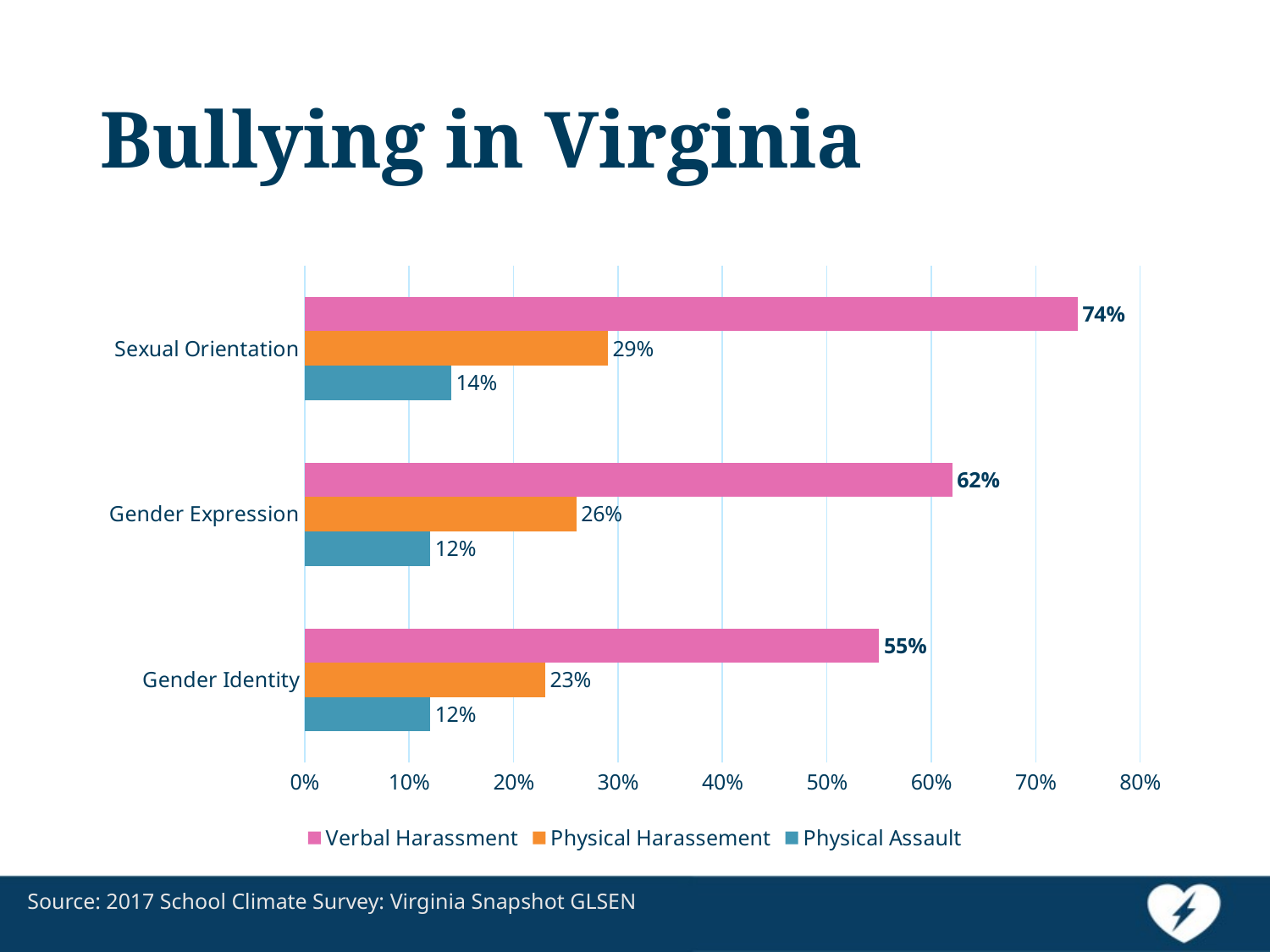
Is the Verbal Harassment value for Gender Expression greater or less than 60%? greater Which category has the highest Verbal Harassment value? Sexual Orientation What is the Physical Assault value for Gender Expression? 12% What kind of chart is shown on the slide? bar chart How many categories are shown on the chart? 3 Which category has the lowest Physical Harassement value? Gender Identity How many series does the legend list? 3 What is the title of the slide containing the chart? Bullying in Virginia What is the difference between the Verbal Harassment values for Sexual Orientation and Gender Identity? 19% Which is larger: the Physical Harassement value for Sexual Orientation or for Gender Expression? Sexual Orientation What is the Physical Harassement value for Gender Identity? 23% What is the Verbal Harassment value for Sexual Orientation? 74%